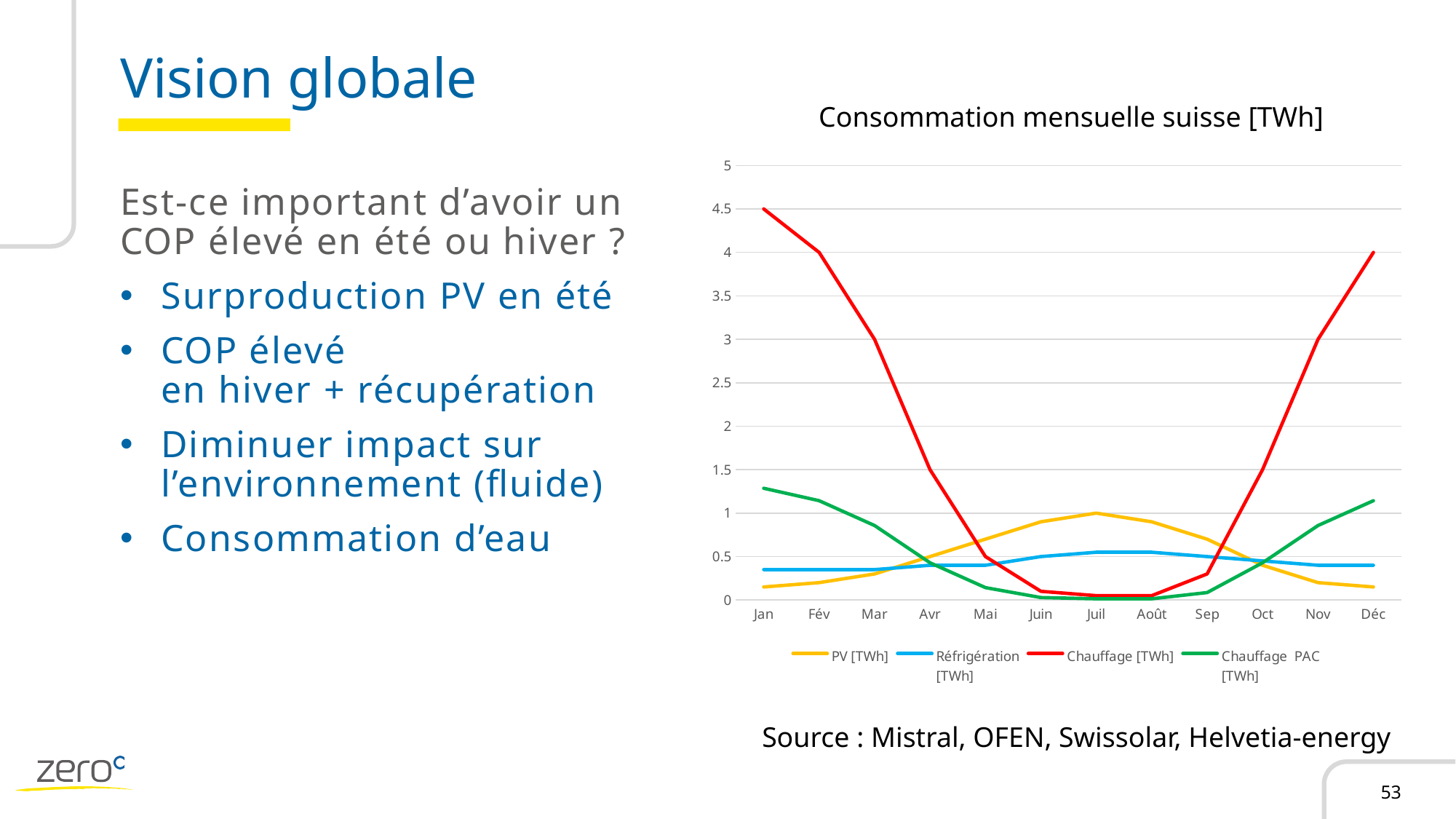
Does Chauffage [TWh] rise or fall from Jan to Juil? fall What is the title of the chart? Consommation mensuelle suisse [TWh] In which month is PV [TWh] highest? Juil How many months are shown on the x axis? 12 In which month is Chauffage [TWh] highest? Jan What is the value of Chauffage [TWh] in Jan? 4.5 Which is larger in Jan: Chauffage [TWh] or Chauffage PAC [TWh]? Chauffage [TWh] What type of chart is shown on the slide? line chart Is the value for Chauffage [TWh] in Mar greater or less than 2.5? greater What is the value of Chauffage [TWh] in Déc? 4 How many series does the legend list? 4 Is the value for Chauffage PAC [TWh] in Juin greater or less than 0.5? less